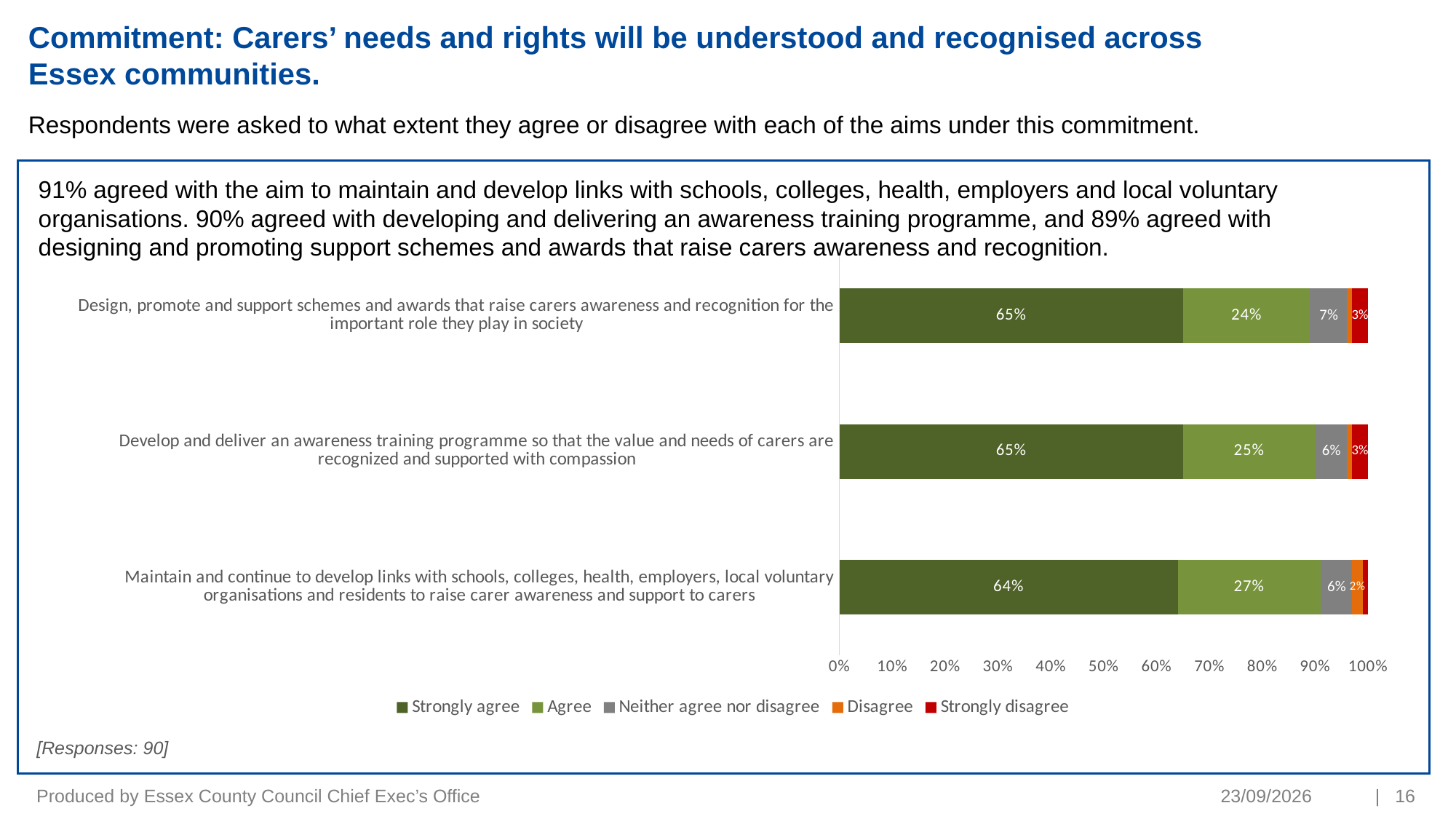
What type of chart is shown on the slide? Stacked bar chart Which aim has the highest 'Agree' percentage? Maintain and continue to develop links with schools, colleges, health, employers, local voluntary organisations and residents to raise carer awareness and support to carers What percentage of respondents strongly disagreed with the aim to develop and deliver an awareness training programme? 3% What percentage of respondents strongly agreed with the aim to design, promote and support schemes and awards that raise carers awareness and recognition? 65% What is the difference between the 'Agree' percentage for the 'Maintain and continue to develop links' aim and the 'Agree' percentage for the 'Design, promote and support schemes and awards' aim? 3% What percentage of respondents neither agreed nor disagreed with the aim to develop and deliver an awareness training programme? 6% How many response categories does the chart legend list? 5 Which colour represents 'Strongly disagree' in the chart? Red Which aim has the lowest 'Strongly agree' percentage? Maintain and continue to develop links with schools, colleges, health, employers, local voluntary organisations and residents to raise carer awareness and support to carers Is the 'Neither agree nor disagree' percentage higher for the 'Design, promote and support schemes and awards' aim or the 'Develop and deliver an awareness training programme' aim? Design, promote and support schemes and awards that raise carers awareness and recognition for the important role they play in society How many aims (categories) are shown in the chart? 3 What percentage of respondents agreed (not strongly) with the aim to maintain and continue to develop links with schools, colleges, health, employers, local voluntary organisations and residents? 27%